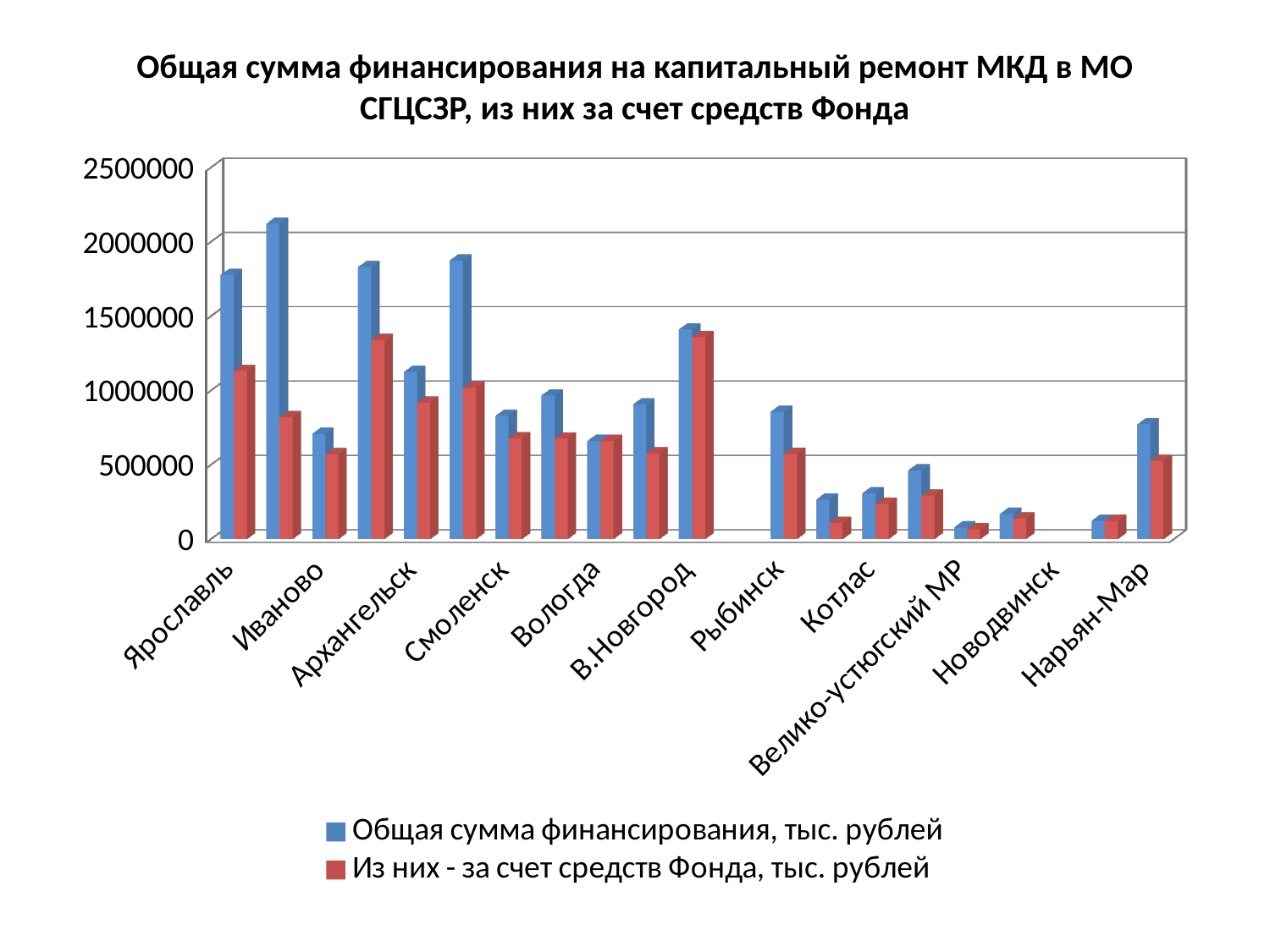
Is the value of 'Общая сумма финансирования, тыс. рублей' for Нарьян-Мар greater or less than 1000000? less What is the second series listed in the legend? Из них - за счет средств Фонда, тыс. рублей For Ярославль, which series has the larger value: 'Общая сумма финансирования, тыс. рублей' or 'Из них - за счет средств Фонда, тыс. рублей'? Общая сумма финансирования, тыс. рублей Is the value of 'Из них - за счет средств Фонда, тыс. рублей' for Ярославль greater or less than 1000000? greater What is the highest value shown on the vertical axis? 2500000 What is the first series listed in the legend? Общая сумма финансирования, тыс. рублей Is the value of 'Общая сумма финансирования, тыс. рублей' for Ярославль greater or less than 1500000? greater How many series does the legend list? 2 How many category labels are shown on the x axis? 11 What kind of chart is shown on the slide? bar chart